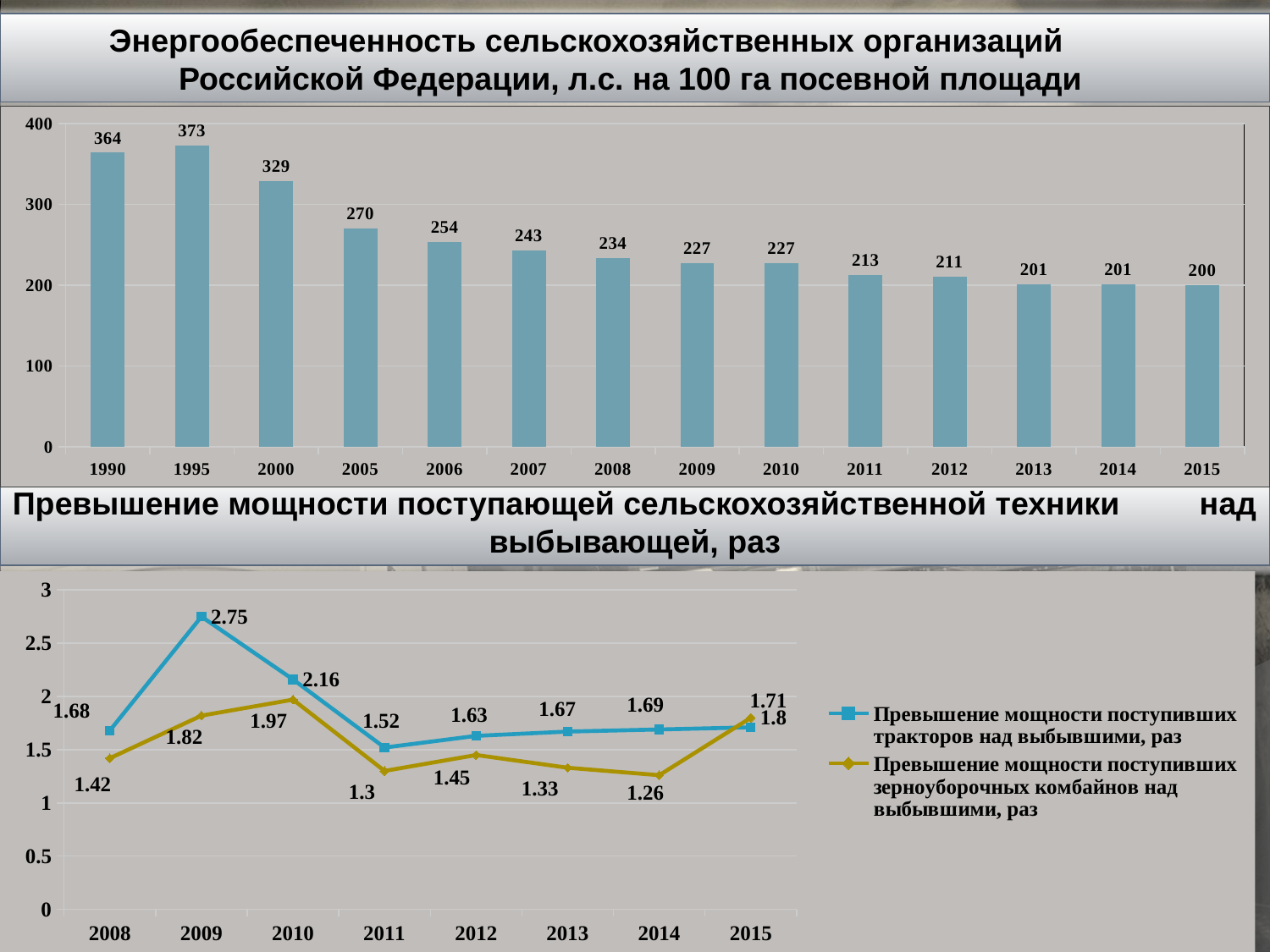
In the bottom chart (Превышение мощности поступающей сельскохозяйственной техники над выбывающей, раз), which is larger in 2015: the value for tractors or the value for grain combines? grain combines (1.8) In the top chart (Энергообеспеченность сельскохозяйственных организаций), what is the value for 1995? 373 In the top chart (Энергообеспеченность сельскохозяйственных организаций), how many years are shown on the x axis? 14 What kind of chart is the top chart (Энергообеспеченность сельскохозяйственных организаций)? bar chart In the top chart (Энергообеспеченность сельскохозяйственных организаций), which year has the highest value? 1995 In the bottom chart (Превышение мощности поступающей сельскохозяйственной техники над выбывающей, раз), what is the value for grain combines (Превышение мощности поступивших зерноуборочных комбайнов над выбывшими) in 2014? 1.26 In the bottom chart (Превышение мощности поступающей сельскохозяйственной техники над выбывающей, раз), how many series does the legend list? 2 In the bottom chart (Превышение мощности поступающей сельскохозяйственной техники над выбывающей, раз), what is the difference between the tractors value and the grain combines value in 2011? 0.22 In the top chart (Энергообеспеченность сельскохозяйственных организаций), which year has the lowest value? 2015 In the bottom chart (Превышение мощности поступающей сельскохозяйственной техники над выбывающей, раз), what is the value for tractors (Превышение мощности поступивших тракторов над выбывшими) in 2009? 2.75 In the top chart (Энергообеспеченность сельскохозяйственных организаций), what is the difference between the values for 1990 and 2015? 164 In the top chart (Энергообеспеченность сельскохозяйственных организаций), do the values generally rise or fall from 1995 to 2015? fall